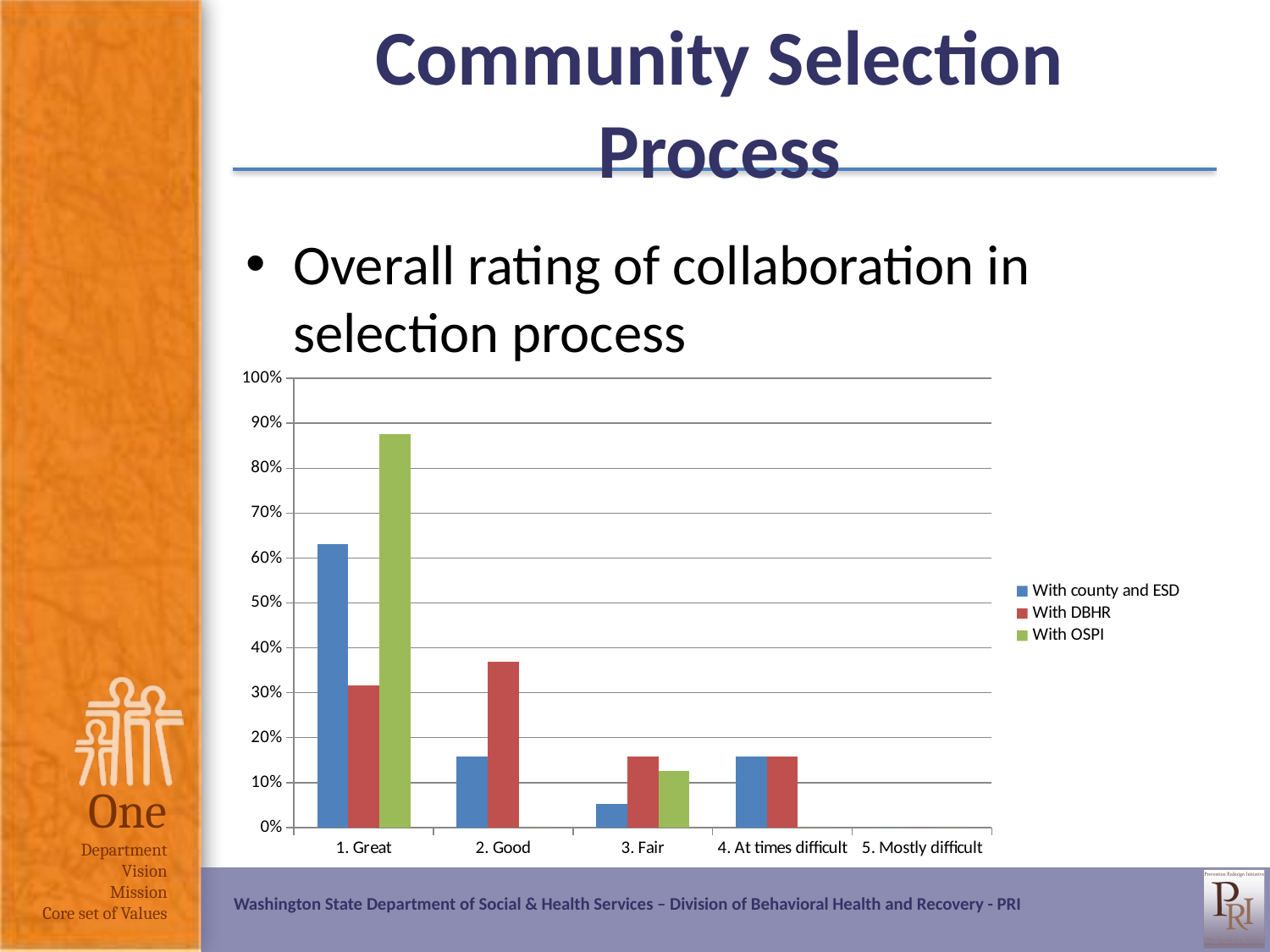
For '1. Great', which series has the larger value: 'With county and ESD' or 'With DBHR'? With county and ESD How many rating categories are shown on the x axis of the chart? 5 Which series is shown in green in the chart legend? With OSPI Is the 'With county and ESD' value for '3. Fair' greater or less than 10%? less Is the 'With OSPI' value for '1. Great' greater or less than 80%? greater Which rating category has the highest bar for the 'With DBHR' series? 2. Good Is the 'With DBHR' value for '2. Good' greater or less than 30%? greater Which rating category has the highest bar for the 'With county and ESD' series? 1. Great What kind of chart is shown on the slide? bar chart Which rating category has the highest bar for the 'With OSPI' series? 1. Great How many series does the chart legend list? 3